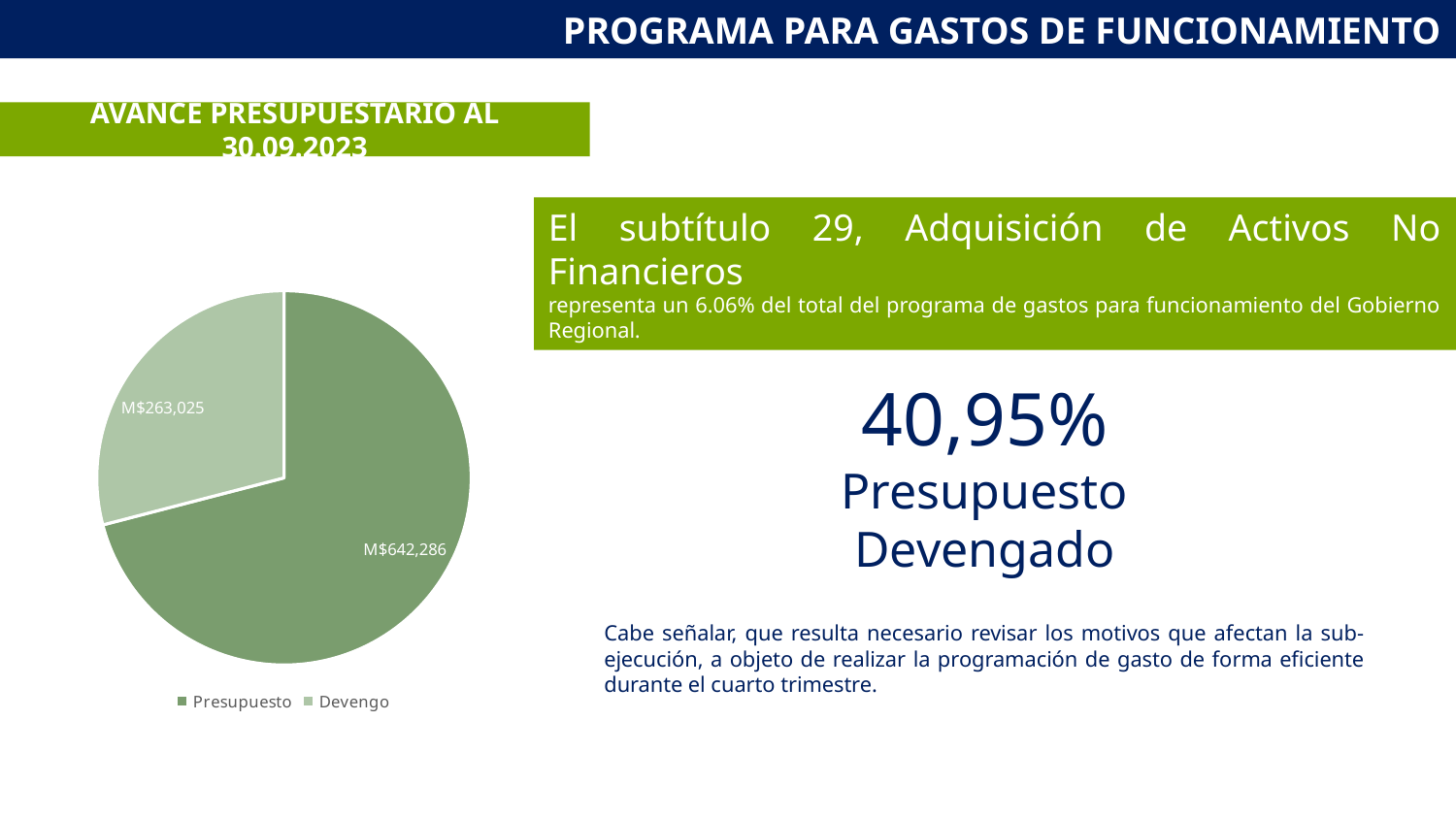
What kind of chart is shown on the slide? Pie chart How many entries does the legend of the pie chart list? 2 What is the difference between the Presupuesto and Devengo values in the pie chart? M$379,261 How many slices does the pie chart have? 2 What are the two legend entries of the pie chart? Presupuesto and Devengo What is the value of the Presupuesto slice in the pie chart? M$642,286 What is the total of the two values shown in the pie chart? M$905,311 Which legend entry is shown in the darker green colour in the pie chart? Presupuesto Which is larger in the pie chart, Presupuesto or Devengo? Presupuesto Which slice of the pie chart is the largest? Presupuesto Which slice of the pie chart is the smallest? Devengo What is the value of the Devengo slice in the pie chart? M$263,025